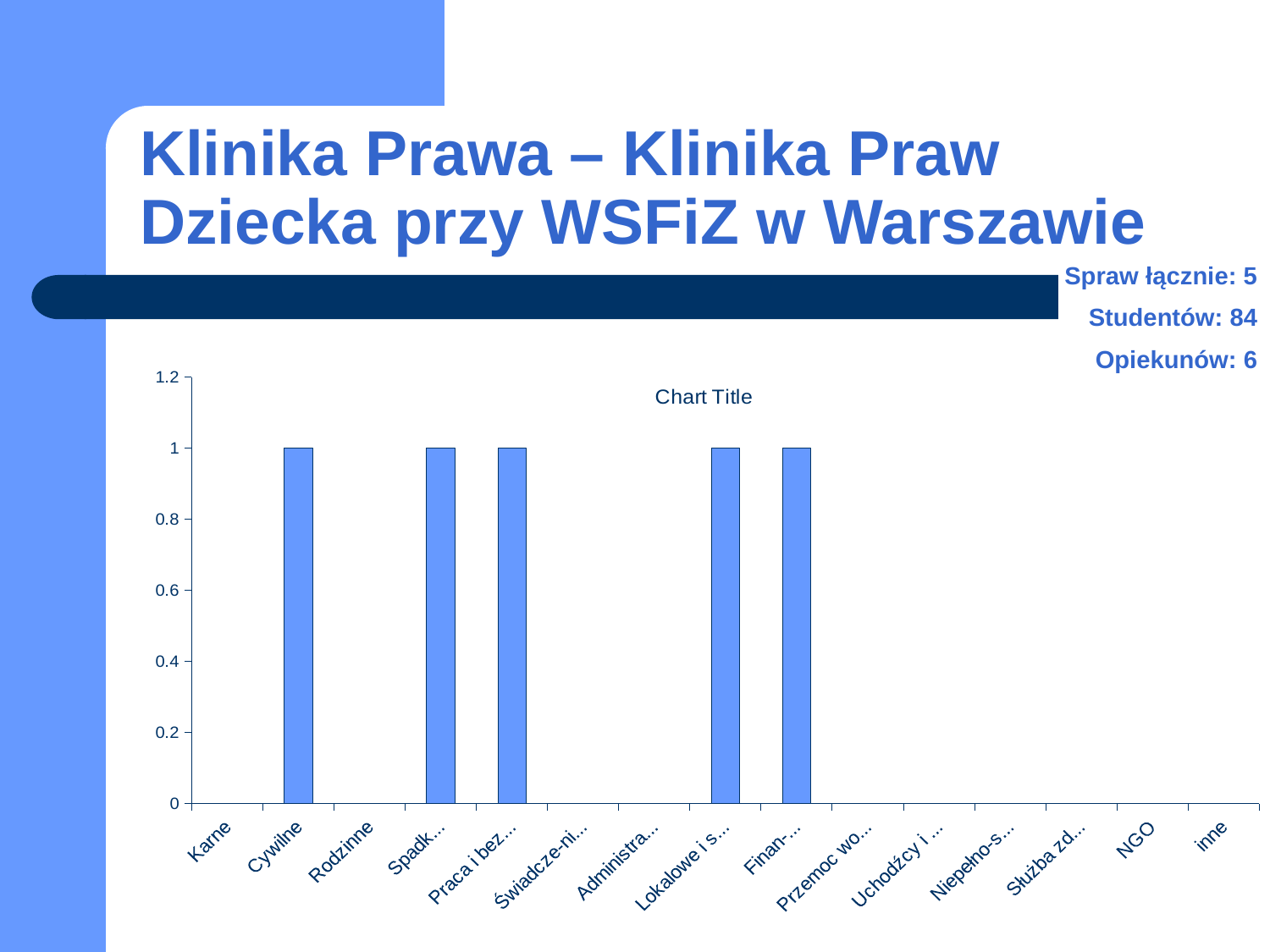
What is the value for NGO in the chart? 0 What title is printed on the chart? Chart Title What is the value of the bar for Cywilne? 1 How many categories are shown along the x axis of the chart? 15 What is the value for Karne in the chart? 0 What kind of chart is shown on the slide? bar chart What is the difference between the value for Cywilne and the value for Karne? 1 What is the value for Rodzinne in the chart? 0 Which is larger, the value for Rodzinne or the value for the category beginning 'Spadk'? Spadk... How many categories in the chart have a bar with a value of 1? 5 Which is larger, the value for Cywilne or the value for Karne? Cywilne What is the highest value labelled on the chart's y axis? 1.2